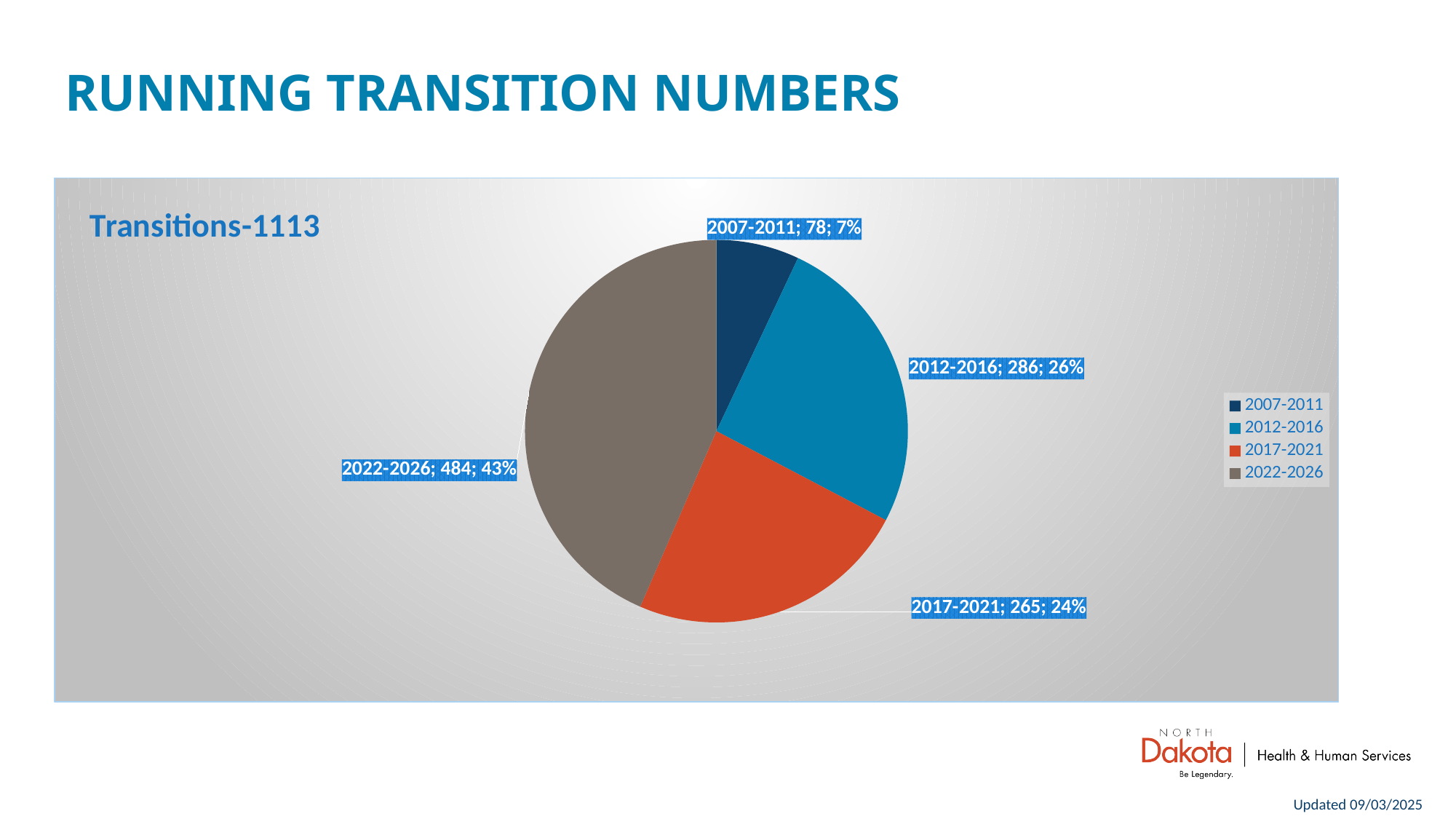
Which period has the largest slice? 2022-2026 Which is larger, the value for 2012-2016 or the value for 2017-2021? 2012-2016 What is the title of the chart? Transitions-1113 What is the difference between the values for 2022-2026 and 2017-2021? 219 What share of the pie does 2012-2016 represent? 26% What is the value for 2017-2021? 265 How many slices does the pie chart have? 4 What kind of chart is shown on the slide? Pie chart What is the value for 2007-2011? 78 What is the value for 2022-2026? 484 What is the value for 2012-2016? 286 Which period has the smallest slice? 2007-2011